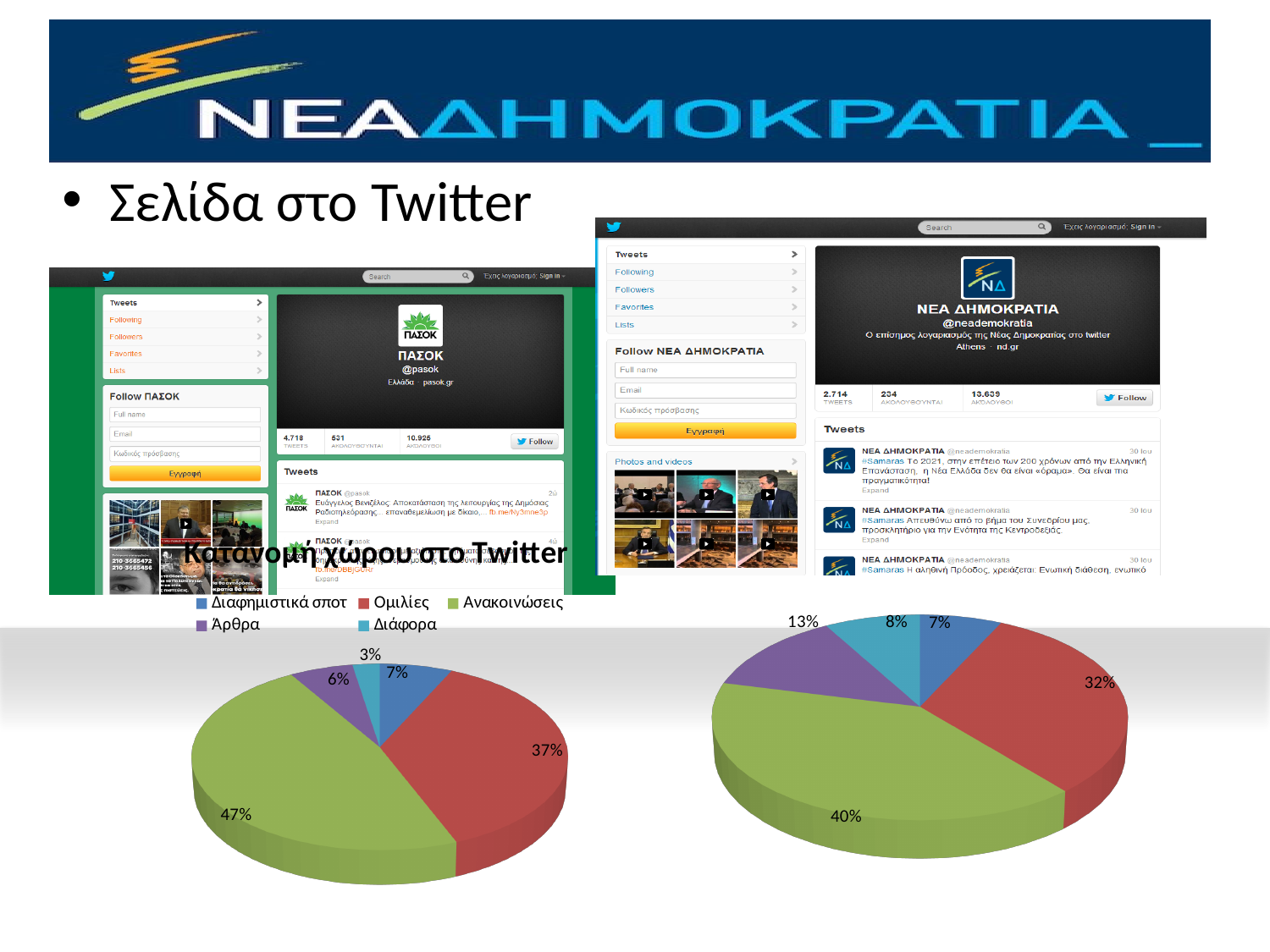
In the right pie chart, what share is labelled for Ανακοινώσεις (green slice)? 40% In the right pie chart, what share is labelled for Άρθρα (purple slice)? 13% In the left pie chart, what share is labelled for Ανακοινώσεις (green slice)? 47% In the right pie chart, which category has the largest slice? Ανακοινώσεις How many categories does the legend of the 'Κατανομή χώρου στο Twitter' charts list? 5 Which pie chart shows a larger share for Άρθρα, the left or the right? Right In the left pie chart, which category has the largest slice? Ανακοινώσεις In the left pie chart, which category has the smallest slice? Διάφορα What kind of charts are shown under the heading 'Κατανομή χώρου στο Twitter'? Pie charts What is the difference between the Ομιλίες share in the left pie chart (37%) and in the right pie chart (32%)? 5%